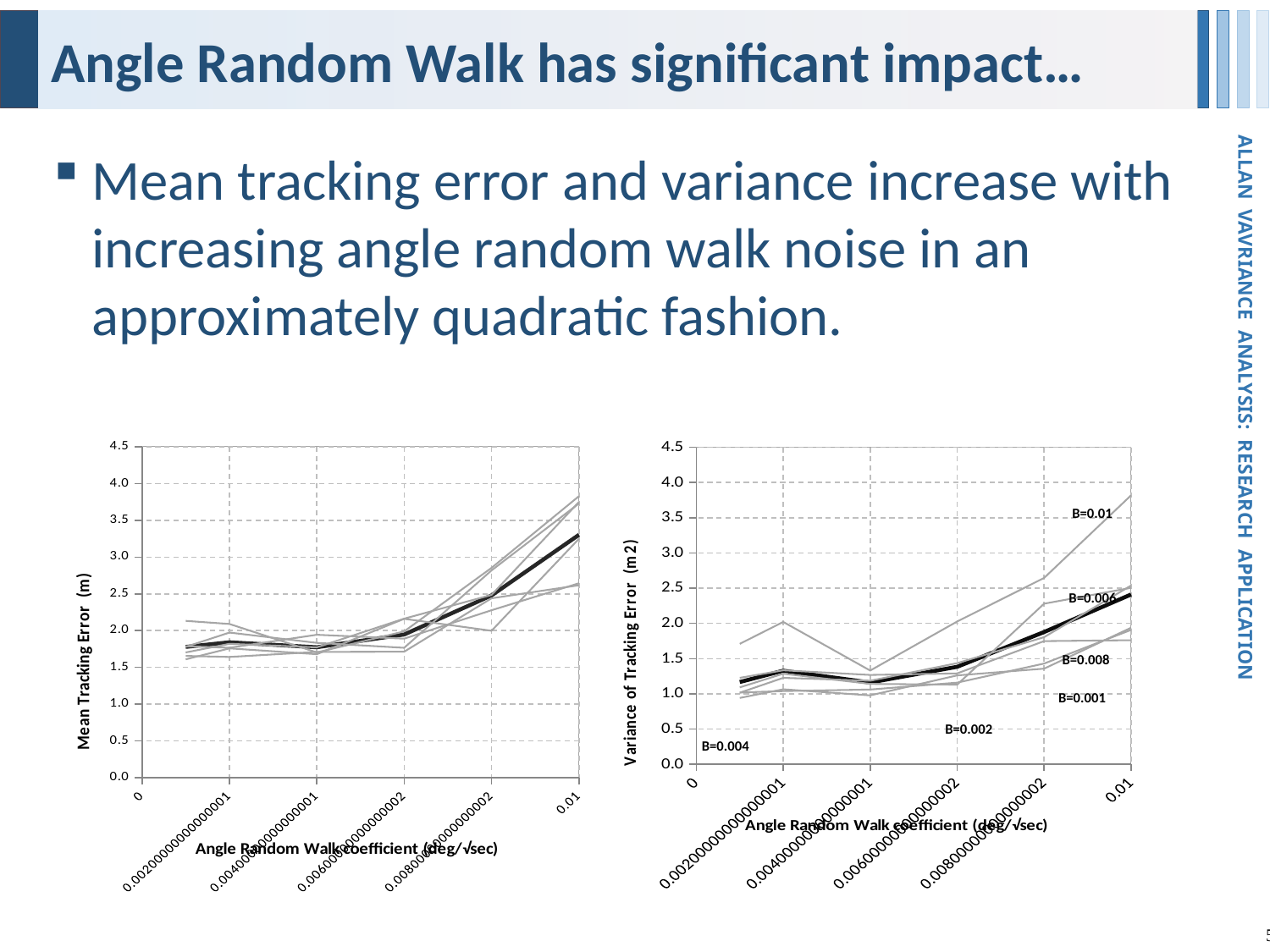
In the right chart, is the value of the B=0.01 line at an Angle Random Walk coefficient of 0.01 greater or less than 3.5? greater In the right chart, is the thick black line's value at 0.01 larger or smaller than its value at 0.002? larger What kind of chart is the right chart (Variance of Tracking Error)? line chart In the right chart, is the value of the thick black line at an Angle Random Walk coefficient of 0.01 greater or less than 2.0? greater In the right chart, which labelled series has the highest value at an Angle Random Walk coefficient of 0.01? B=0.01 In the left chart, does the thick black line generally rise or fall as the Angle Random Walk coefficient increases from 0.004 to 0.01? rise In the right chart, is the value of the thick black line at an Angle Random Walk coefficient of 0.002 greater or less than 1.5? less What kind of chart is the left chart (Mean Tracking Error)? line chart What is the y-axis title of the left chart? Mean Tracking Error (m) What is the y-axis title of the right chart? Variance of Tracking Error (m2)